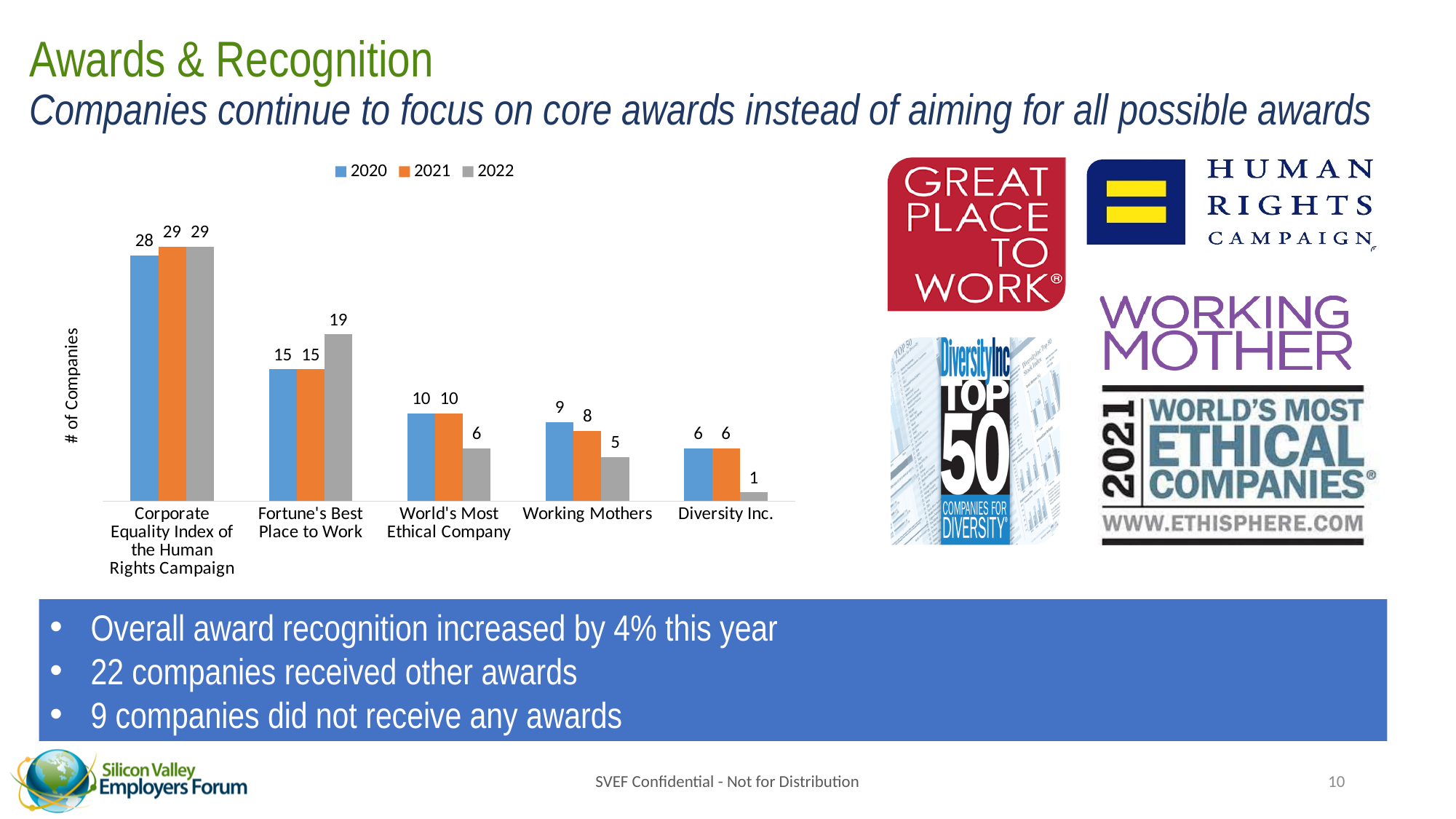
What is the 2021 value for Working Mothers? 8 What is the difference between the 2022 and 2021 values for Fortune's Best Place to Work? 4 How many award categories are shown on the x axis? 5 Which award category has the lowest number of companies in 2022? Diversity Inc. How many series does the legend list? 3 What kind of chart is shown on the slide? Bar chart How many companies received the Diversity Inc. award in 2022? 1 Which is larger for World's Most Ethical Company: the 2020 value or the 2022 value? 2020 What is the 2022 value for Fortune's Best Place to Work? 19 Which award category has the highest number of companies in 2020? Corporate Equality Index of the Human Rights Campaign What is the label of the y axis? # of Companies How many companies received the Corporate Equality Index of the Human Rights Campaign award in 2022? 29